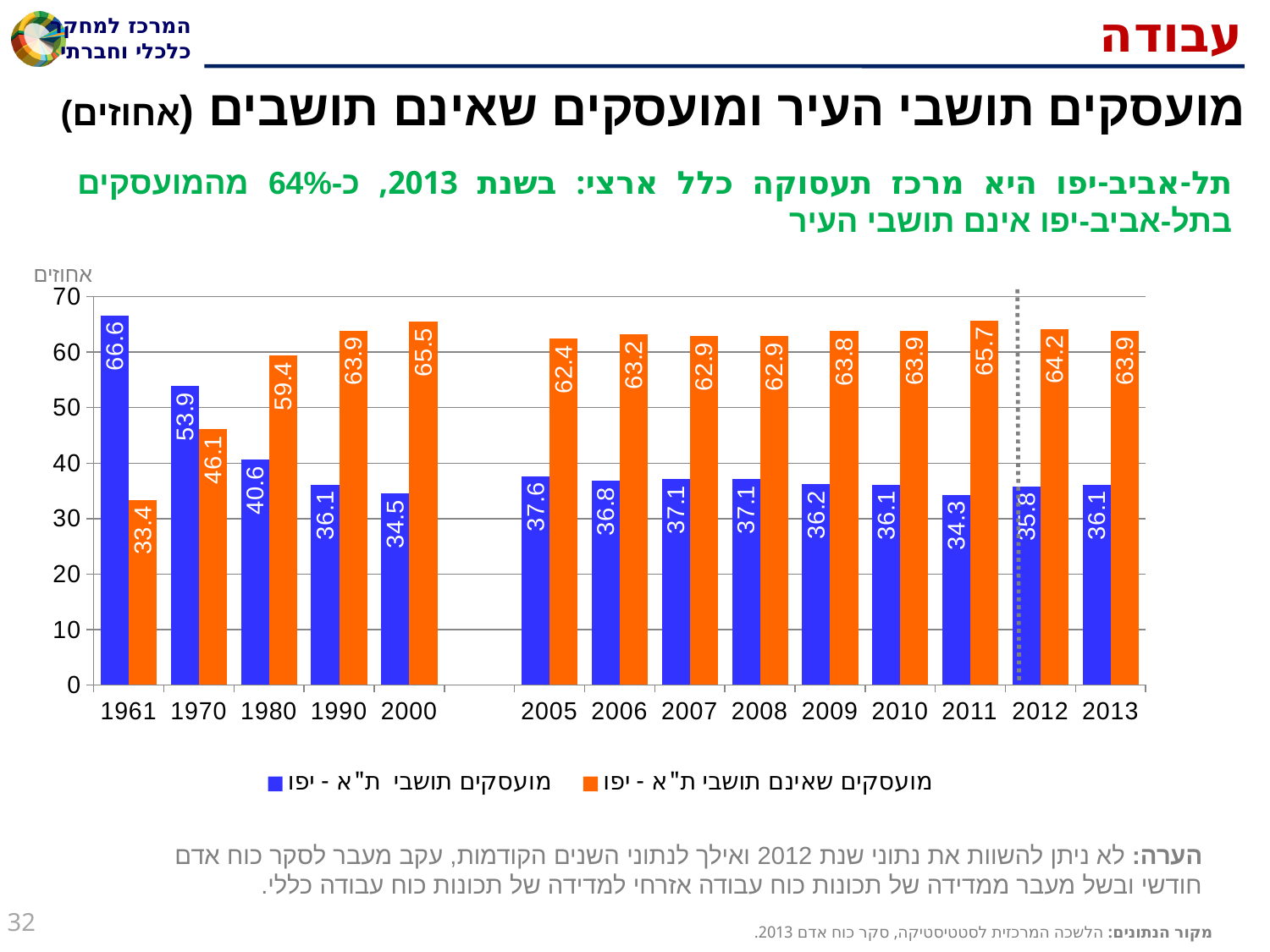
How many series does the legend list? 2 What type of chart is shown on the slide? bar chart In which year is the blue series (מועסקים תושבי ת"א - יפו) at its lowest? 2011 What is the value of the blue series (מועסקים תושבי ת"א - יפו) for 2011? 34.3 What is the value of the blue series (מועסקים תושבי ת"א - יפו) for 1961? 66.6 Does the blue series (מועסקים תושבי ת"א - יפו) rise or fall from 1961 to 2000? fall In which year is the orange series (מועסקים שאינם תושבי ת"א - יפו) at its highest? 2011 What is the difference between the blue and orange values for 1961? 33.2 Which series has the larger value in 1970, blue (תושבי ת"א - יפו) or orange (שאינם תושבי ת"א - יפו)? blue (תושבי ת"א - יפו) What is the value of the orange series (מועסקים שאינם תושבי ת"א - יפו) for 2013? 63.9 How many years are shown on the x axis of the chart? 14 What is the total of the blue and orange values for 2012? 100